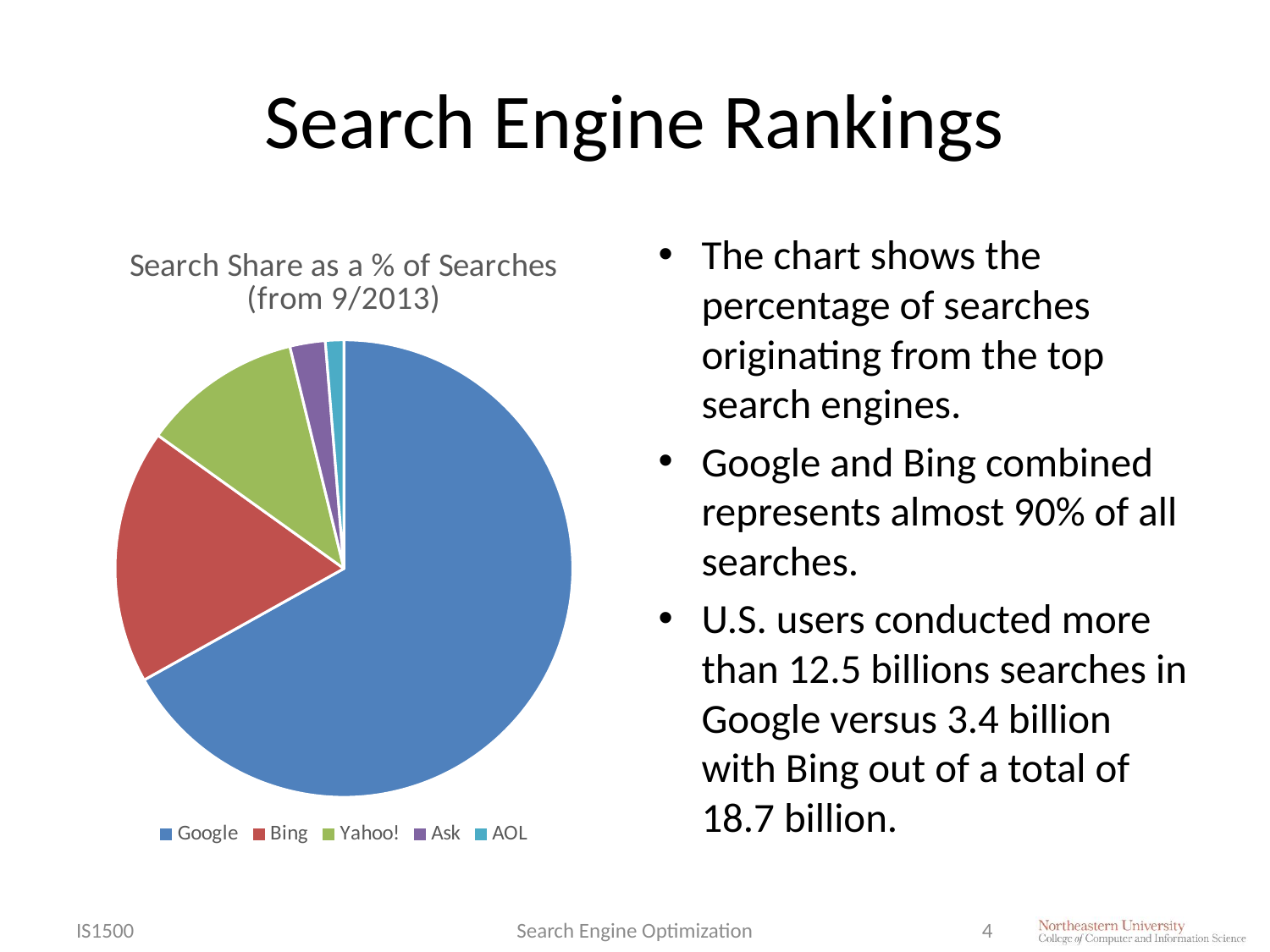
What kind of chart is shown on the slide? pie chart Which has the larger share in the pie chart, Yahoo! or Ask? Yahoo! Which search engine has the second-largest share in the pie chart? Bing Which search engine has the largest share in the pie chart? Google What colour is the Google slice in the pie chart? blue Which search engine has the smallest share in the pie chart? AOL How many slices does the pie chart have? 5 What is the title of the chart? Search Share as a % of Searches (from 9/2013) Which has the larger share in the pie chart, Google or Bing? Google Which has the larger share in the pie chart, Bing or Yahoo!? Bing How many entries does the chart legend list? 5